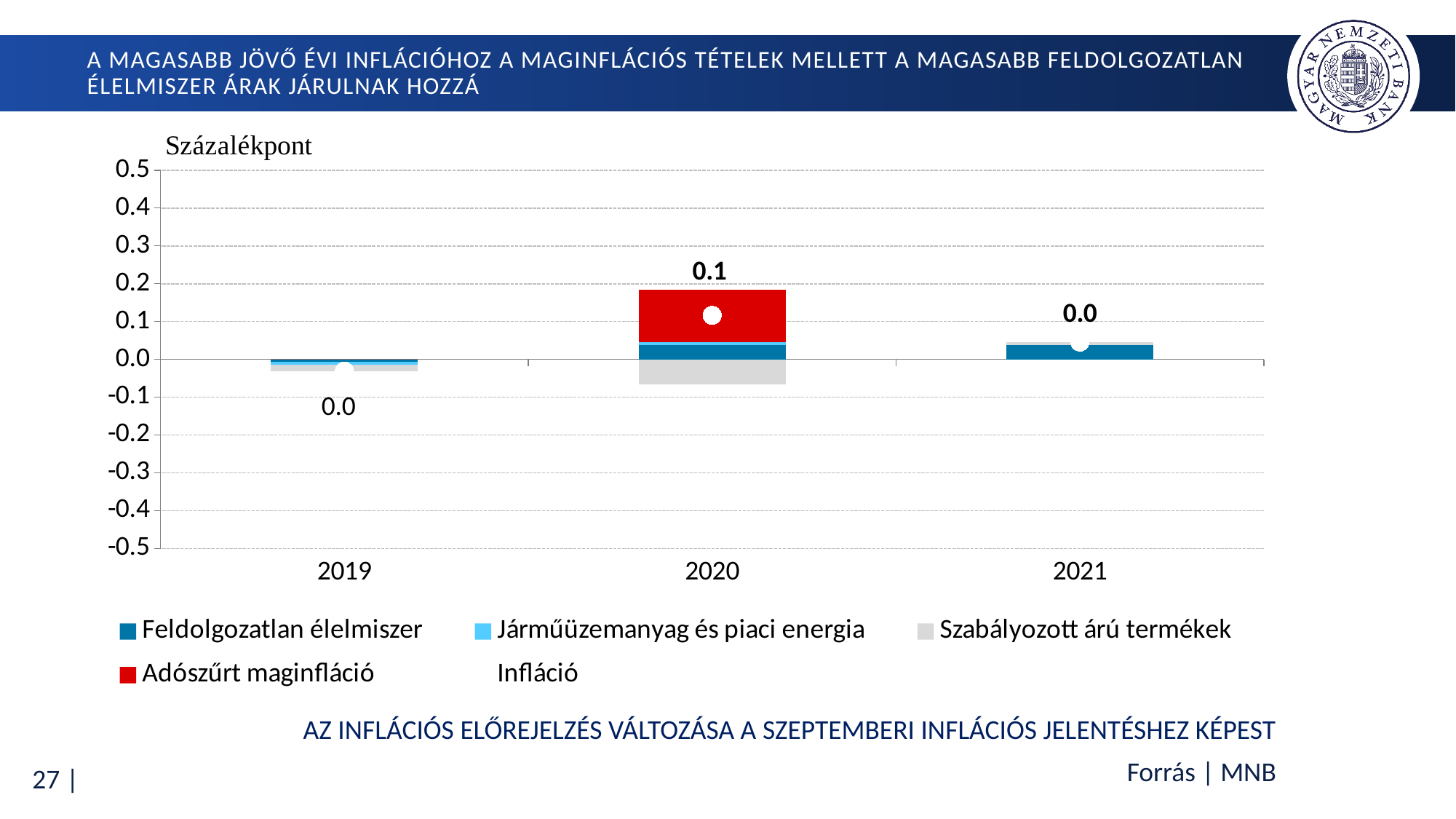
How many series does the legend list? 5 Is the value for Feldolgozatlan élelmiszer in 2021 greater or less than 0.0? greater What unit is shown above the y axis of the chart? Százalékpont Is the value for Szabályozott árú termékek in 2020 greater or less than 0.0? less What is the difference between the Infláció values for 2020 and 2019? 0.1 What kind of chart is shown on the slide? Stacked bar chart combined with a line (marker) series for Infláció How many years are shown on the x axis? 3 Which year has the larger Infláció value, 2020 or 2021? 2020 What is the value of the Infláció series for 2020? 0.1 In which year is the Infláció value highest? 2020 What is the value of the Infláció series for 2021? 0.0 What is the value of the Infláció series for 2019? 0.0